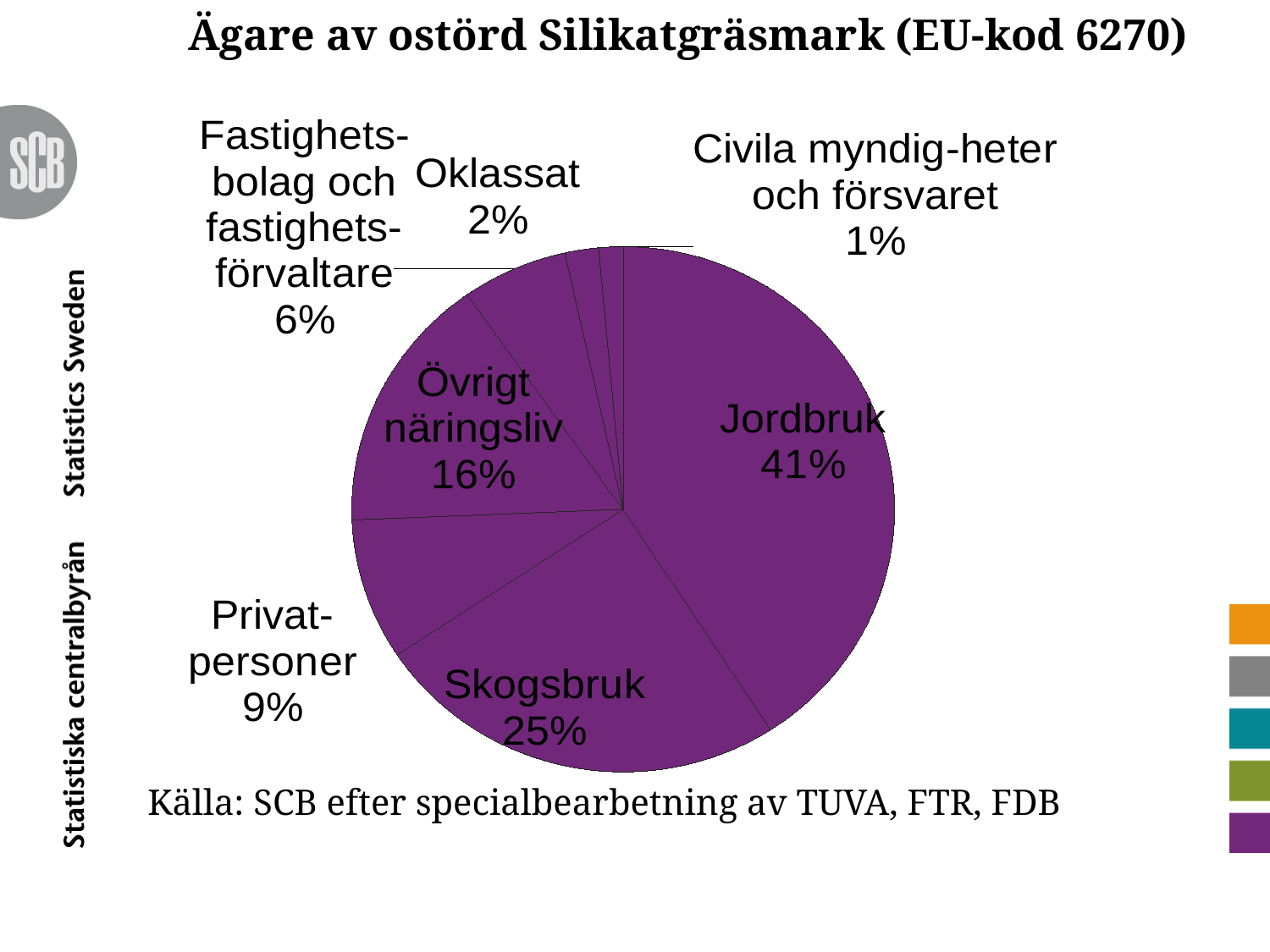
What kind of chart is shown on the slide? Pie chart What is the value shown for Privatpersoner? 9% What is the difference in percentage points between Jordbruk and Skogsbruk? 16 How many slices does the pie chart have? 7 Which is larger, Övrigt näringsliv or Privatpersoner? Övrigt näringsliv Which category has the smallest slice of the pie? Civila myndigheter och försvaret What share of the pie does Jordbruk hold? 41% What is the value shown for Övrigt näringsliv? 16% What is the value shown for Oklassat? 2% Which category has the largest slice of the pie? Jordbruk What share of the pie does Skogsbruk hold? 25% What is the title of the chart? Ägare av ostörd Silikatgräsmark (EU-kod 6270)